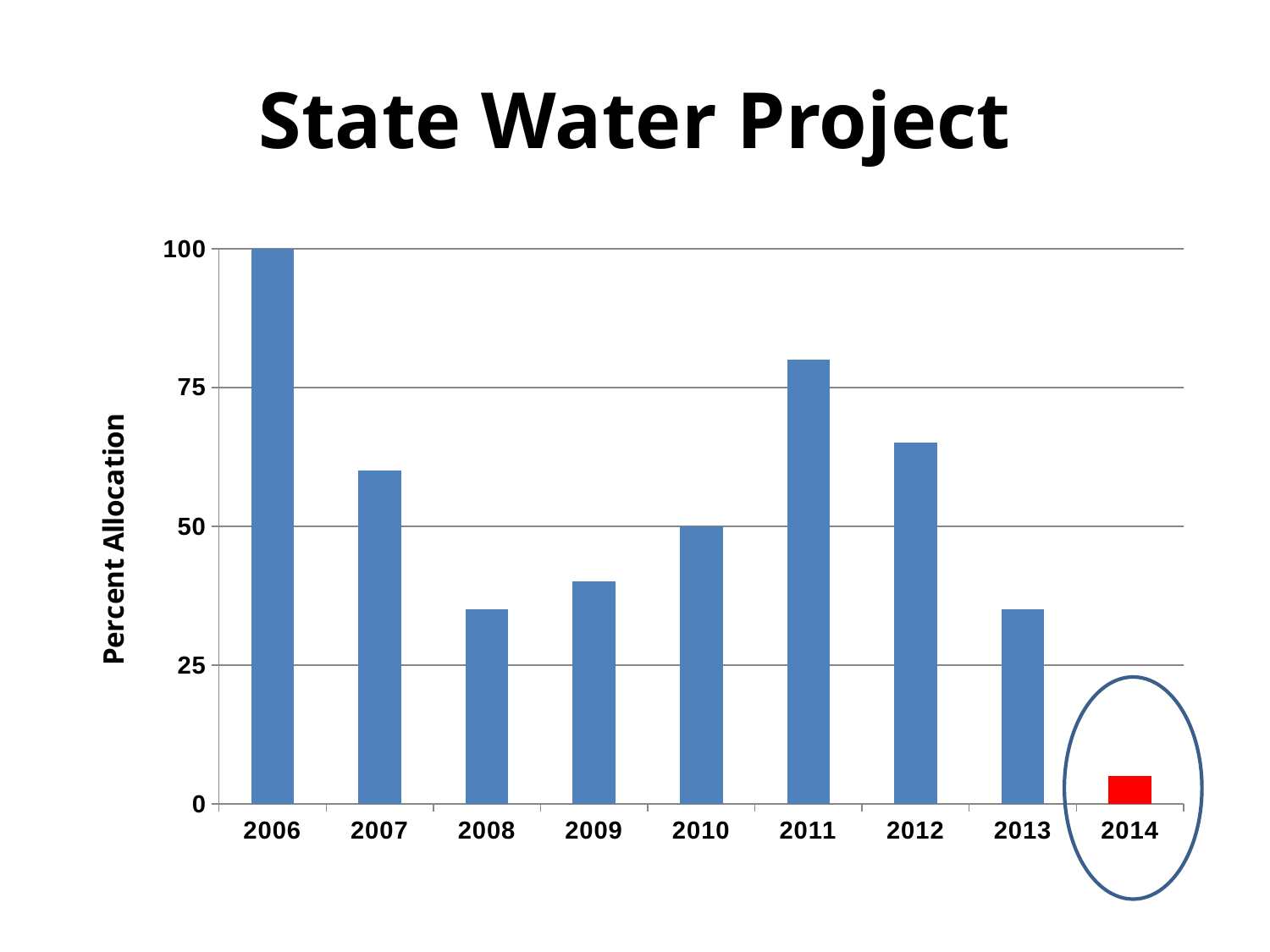
Do the values rise or fall from 2006 to 2008? fall How many years are shown on the x axis? 9 Which year has the larger Percent Allocation, 2011 or 2012? 2011 Is the value for 2014 greater or less than 25? less What kind of chart is shown on the slide? bar chart Is the value for 2011 greater or less than 75? greater What colour is the bar for 2014? red What is the Percent Allocation for 2006? 100 Which year has the lowest Percent Allocation? 2014 Is the value for 2007 greater or less than 50? greater Which year has the highest Percent Allocation? 2006 What is the Percent Allocation for 2010? 50